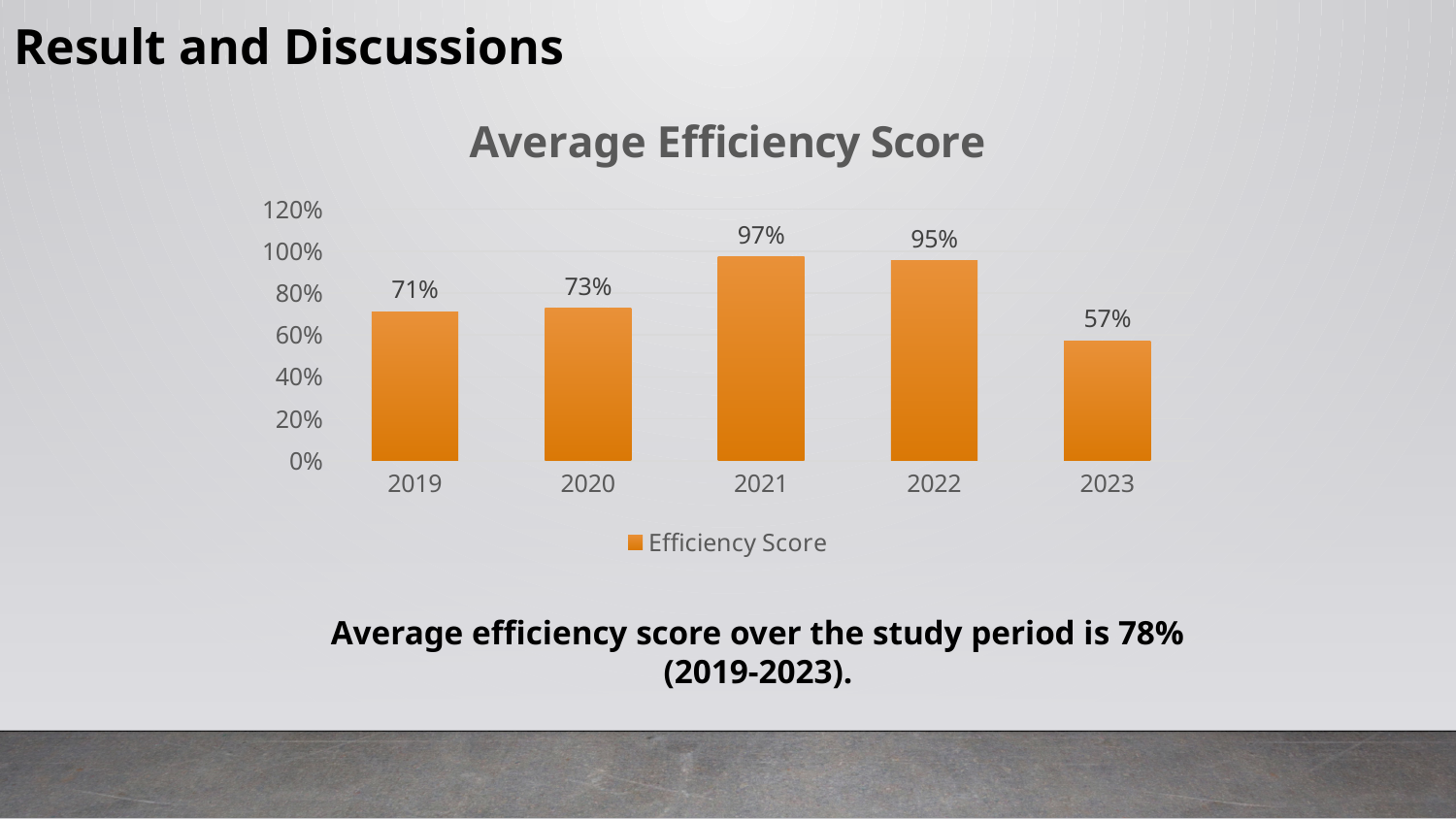
What is the efficiency score for 2021? 97% Which year has a higher efficiency score, 2022 or 2020? 2022 Which year has the lowest efficiency score? 2023 What is the difference between the efficiency scores for 2021 and 2023? 40% What is the efficiency score for 2019? 71% How many series does the legend list? 1 What is the efficiency score for 2023? 57% What is the title of the chart? Average Efficiency Score What kind of chart is shown on the slide? Bar chart How many years are shown on the x axis of the chart? 5 What is the difference between the efficiency scores for 2020 and 2019? 2% Which year has the highest efficiency score? 2021